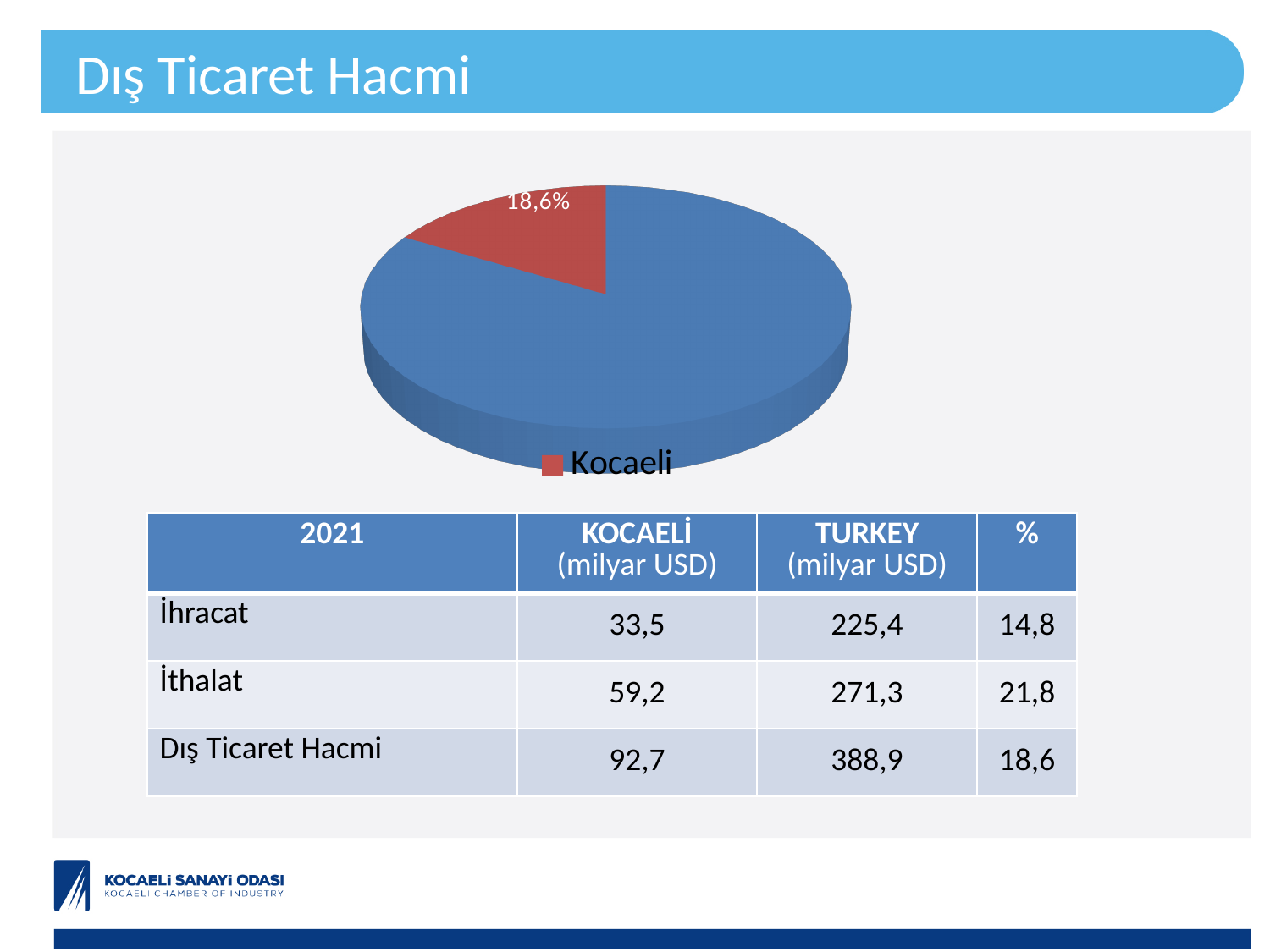
Which slice of the pie chart is the largest? the blue slice What kind of chart is shown on the slide? pie chart Is the Kocaeli slice larger or smaller than the other slice of the pie? smaller Which entry is listed in the pie chart's legend? Kocaeli Is the Kocaeli share of the pie greater or less than 50%? less What share of the pie does the Kocaeli slice represent? 18,6% Which slice of the pie chart is the smallest? Kocaeli How many slices does the pie chart have? 2 How many entries does the pie chart's legend list? 1 What colour is the Kocaeli slice in the pie chart? red